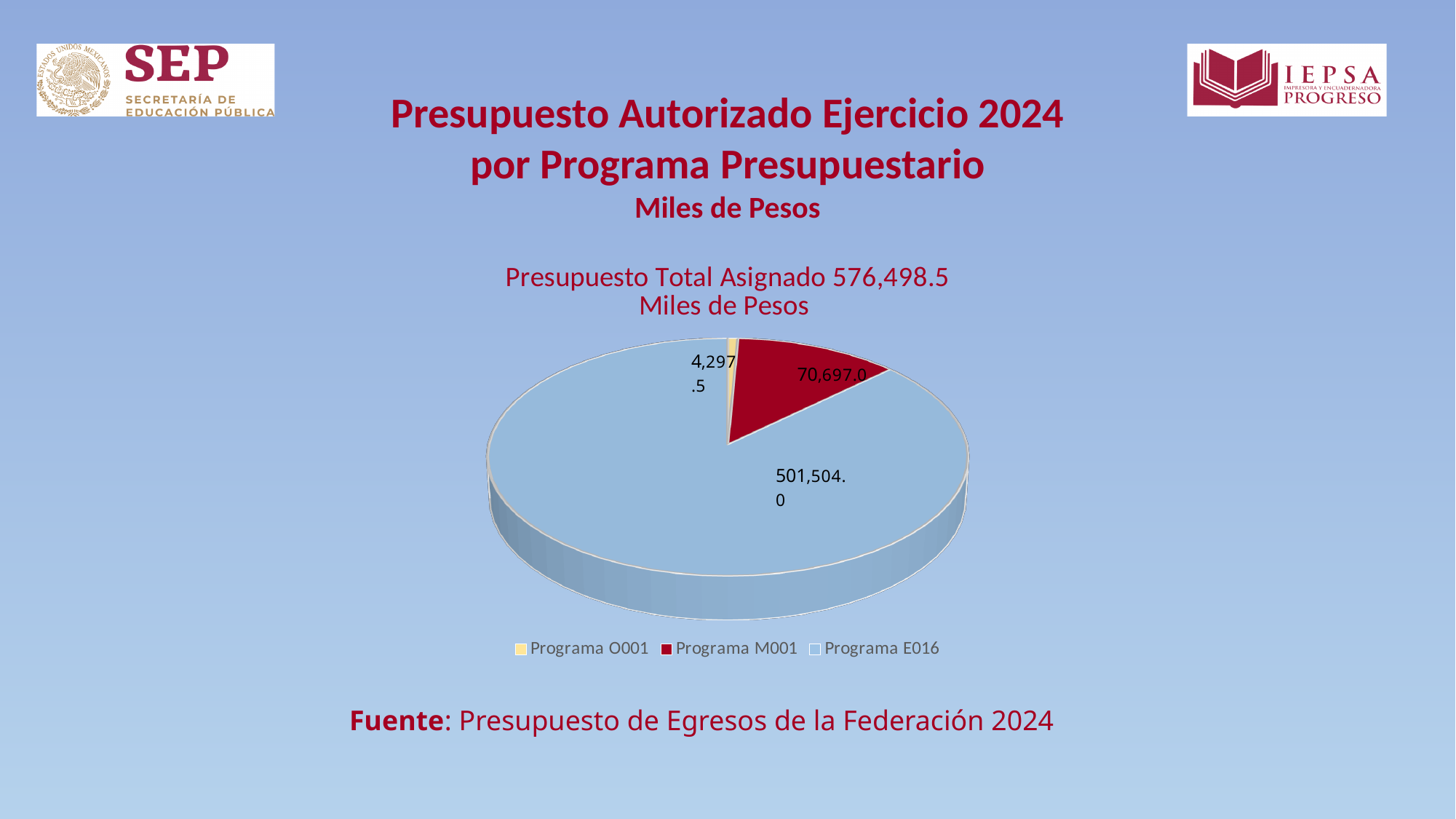
What kind of chart is shown on the slide? Pie chart What is the value shown for Programa O001 in the pie chart? 4,297.5 How many slices does the pie chart have? 3 Which program has the smallest slice of the pie chart? Programa O001 What is the difference between the values for Programa M001 and Programa O001? 66,399.5 What is the value shown for Programa E016 in the pie chart? 501,504.0 Which program has the largest slice of the pie chart? Programa E016 What colour is the slice for Programa M001? Dark red Which is larger, the value for Programa M001 or the value for Programa O001? Programa M001 What is the total budget stated in the chart title? 576,498.5 What is the value shown for Programa M001 in the pie chart? 70,697.0 What is the difference between the values for Programa E016 and Programa M001? 430,807.0